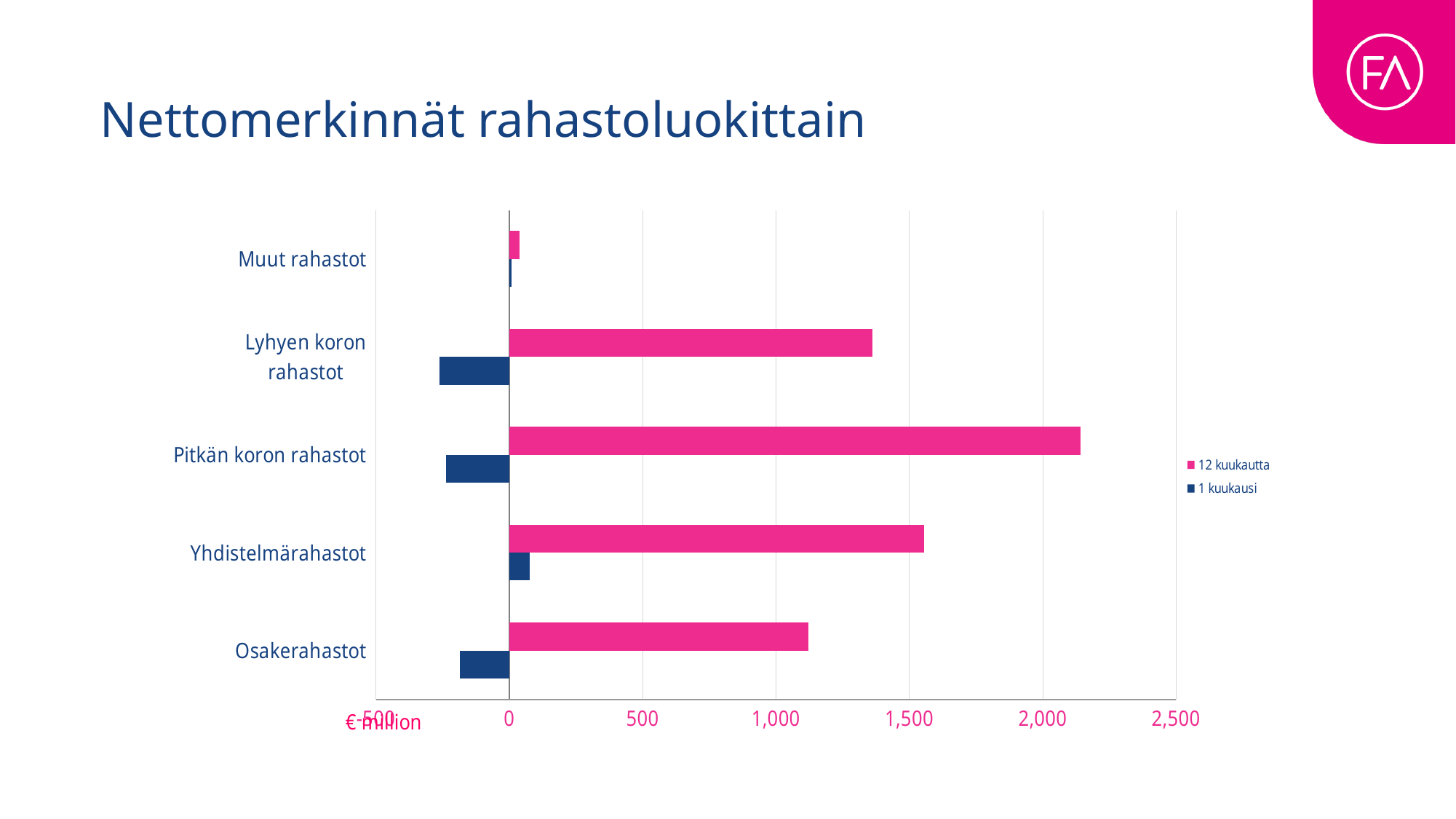
How many fund categories are shown on the chart? 5 What kind of chart is shown on the slide? bar chart Which category has the highest value for the 12 kuukautta series? Pitkän koron rahastot For the 12 kuukautta series, which is larger: Yhdistelmärahastot or Osakerahastot? Yhdistelmärahastot How many series does the legend list? 2 What unit is shown on the horizontal axis of the chart? € million Is the 1 kuukausi value for Osakerahastot greater or less than 0? less What is the title of the chart on the slide? Nettomerkinnät rahastoluokittain Which category has the lowest value for the 12 kuukautta series? Muut rahastot Is the 12 kuukautta value for Pitkän koron rahastot greater or less than 2,000? greater Is the 12 kuukautta value for Lyhyen koron rahastot greater or less than 1,000? greater Which category has the highest value for the 1 kuukausi series? Yhdistelmärahastot